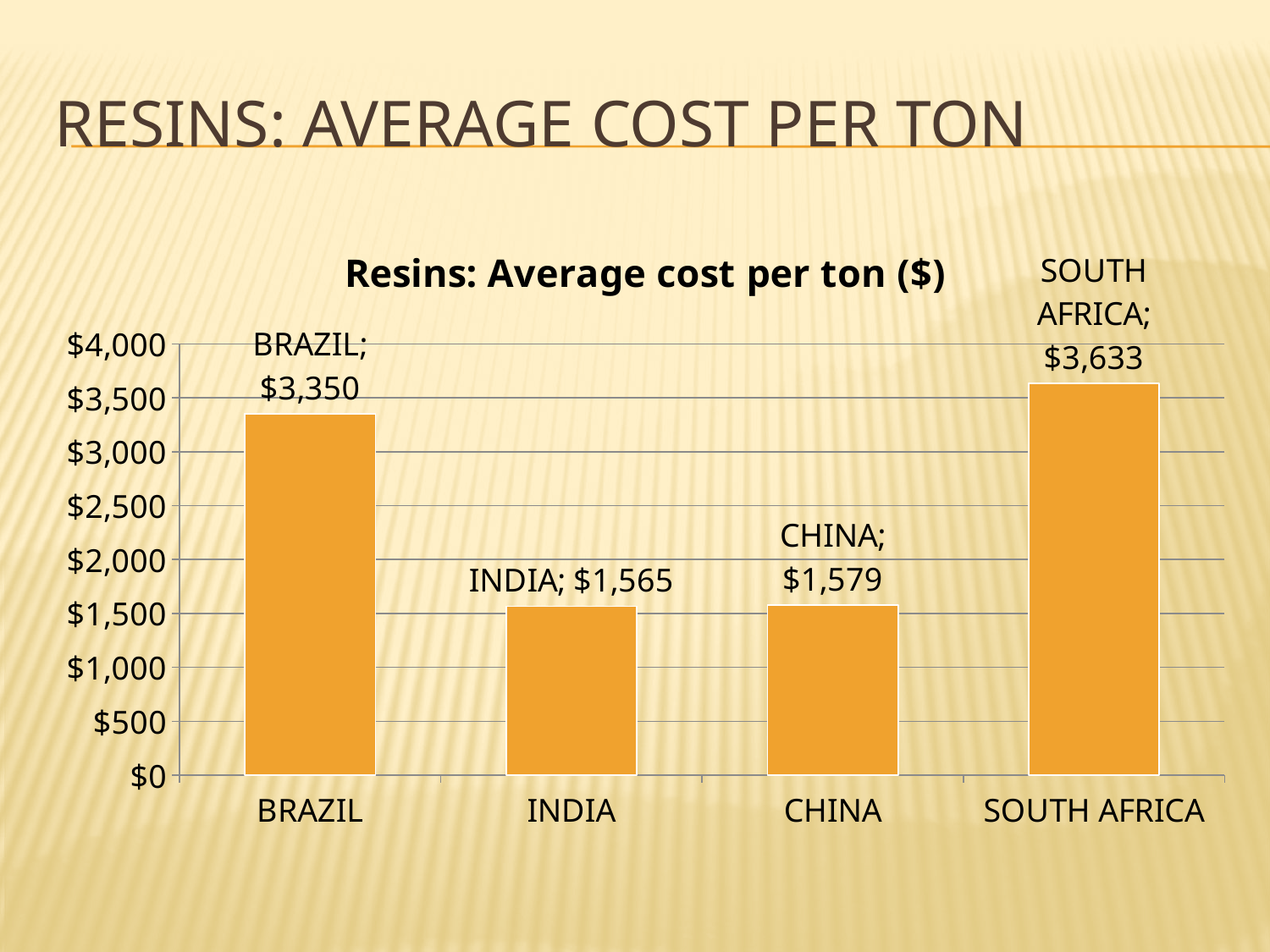
What is the average cost per ton for South Africa? $3,633 How many countries are shown in the chart? 4 What is the average cost per ton for China? $1,579 What kind of chart is shown on the slide? Bar chart What is the title of the chart? Resins: Average cost per ton ($) What is the difference between the average cost per ton for China and India? $14 What is the difference between the average cost per ton for South Africa and Brazil? $283 Which country has the highest average cost per ton? South Africa What is the average cost per ton for India? $1,565 Which has a higher average cost per ton, Brazil or India? Brazil Which country has the lowest average cost per ton? India What is the average cost per ton for Brazil? $3,350